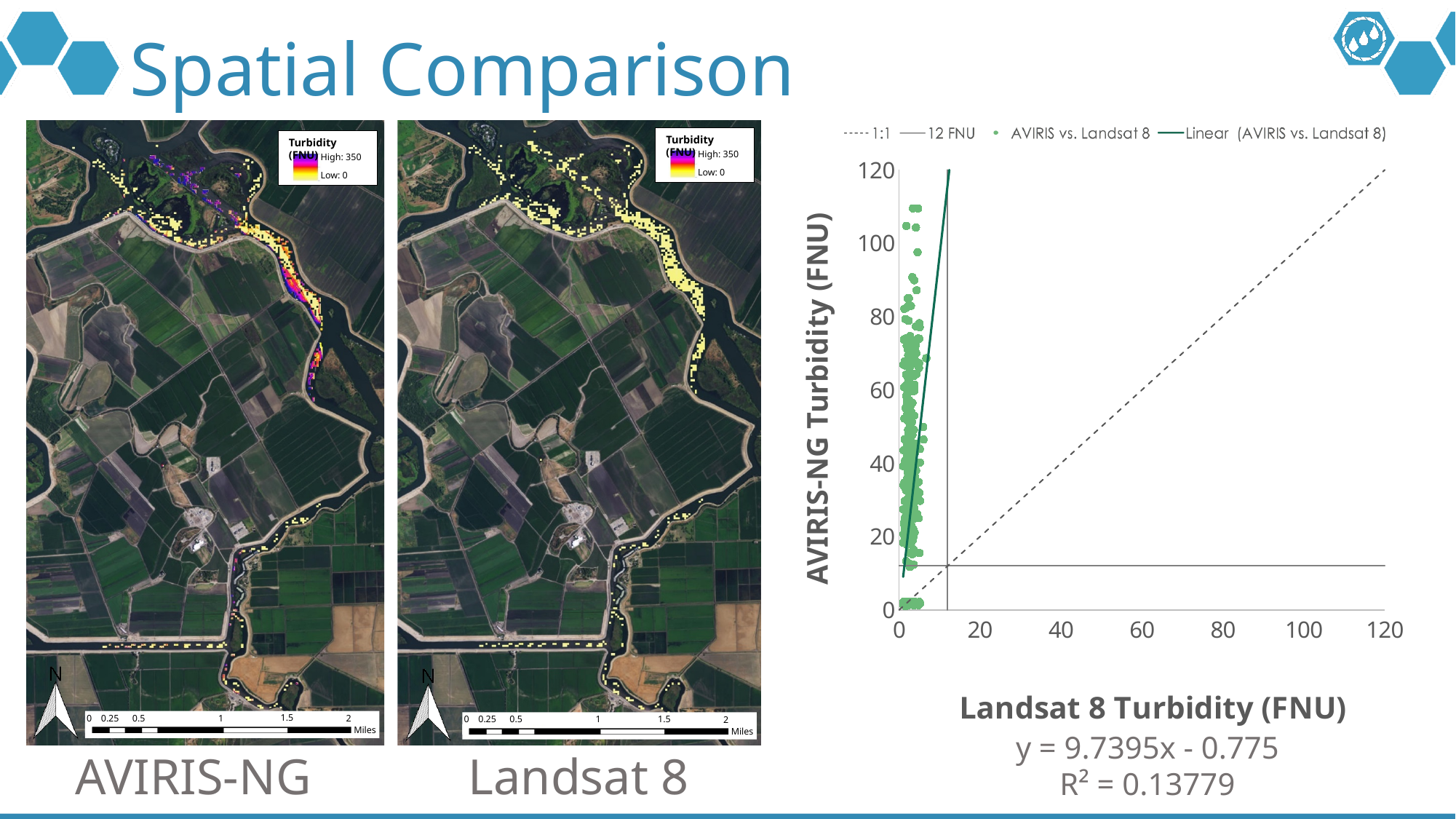
How many entries does the legend of the scatter chart list? 4 What is the maximum value shown on the y axis of the scatter chart? 120 In the scatter chart, are the Landsat 8 turbidity values of the plotted points greater or less than 20? less What is the label of the x axis of the scatter chart? Landsat 8 Turbidity (FNU) What is the label of the y axis of the scatter chart? AVIRIS-NG Turbidity (FNU) What is the maximum value shown on the x axis of the scatter chart? 120 What is the 'High' value of the turbidity legend on the AVIRIS-NG map? 350 Does the linear fit line in the scatter chart rise or fall as Landsat 8 turbidity increases? rise Is the slope of the linear fit in the scatter chart greater or less than the slope of the 1:1 line? greater What kind of chart is shown on the right side of the slide? scatter chart What is the equation of the linear fit shown below the scatter chart? y = 9.7395x - 0.775 What R² value is shown for the linear fit in the scatter chart? R² = 0.13779